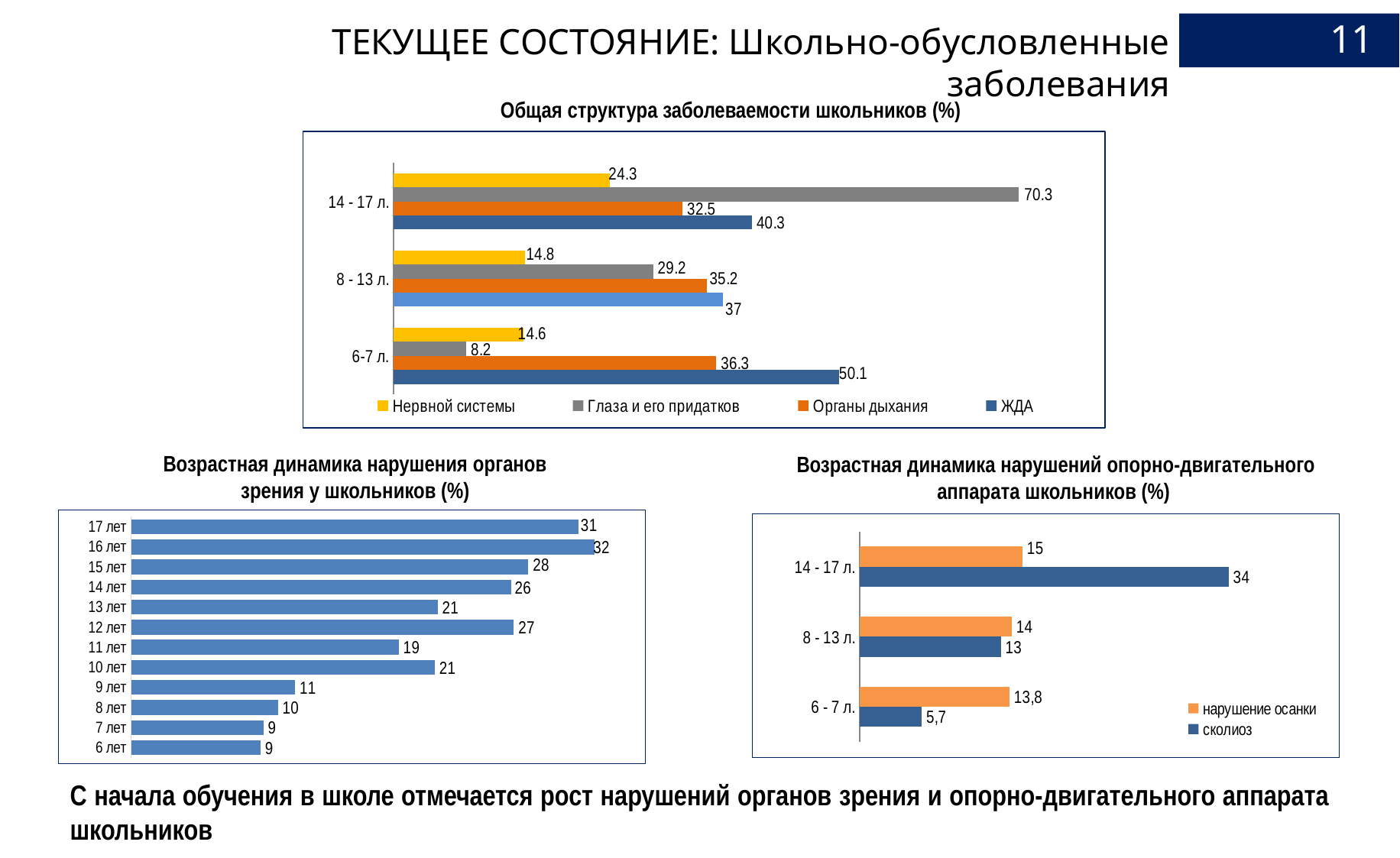
In the chart 'Возрастная динамика нарушений опорно-двигательного аппарата школьников (%)', which is larger in the 6 - 7 л. group: 'нарушение осанки' or 'сколиоз'? нарушение осанки In the chart 'Общая структура заболеваемости школьников (%)', what is the value for 'ЖДА' in the 6-7 л. group? 50.1 In the chart 'Общая структура заболеваемости школьников (%)', which age group has the highest value for 'Глаза и его придатков'? 14 - 17 л. In the chart 'Возрастная динамика нарушения органов зрения у школьников (%)', how many age categories are shown? 12 In the chart 'Возрастная динамика нарушений опорно-двигательного аппарата школьников (%)', what is the difference between 'сколиоз' and 'нарушение осанки' in the 14 - 17 л. group? 19 In the chart 'Возрастная динамика нарушения органов зрения у школьников (%)', what is the value for 16 лет? 32 In the chart 'Возрастная динамика нарушений опорно-двигательного аппарата школьников (%)', what is the value for 'сколиоз' in the 14 - 17 л. group? 34 In the chart 'Возрастная динамика нарушения органов зрения у школьников (%)', what kind of chart is it? Bar chart In the chart 'Общая структура заболеваемости школьников (%)', what is the value for 'Глаза и его придатков' in the 14 - 17 л. group? 70.3 In the chart 'Общая структура заболеваемости школьников (%)', how many series does the legend list? 4 In the chart 'Возрастная динамика нарушения органов зрения у школьников (%)', which age has the highest value? 16 лет In the chart 'Общая структура заболеваемости школьников (%)', what is the difference between 'Органы дыхания' and 'Нервной системы' in the 8 - 13 л. group? 20.4